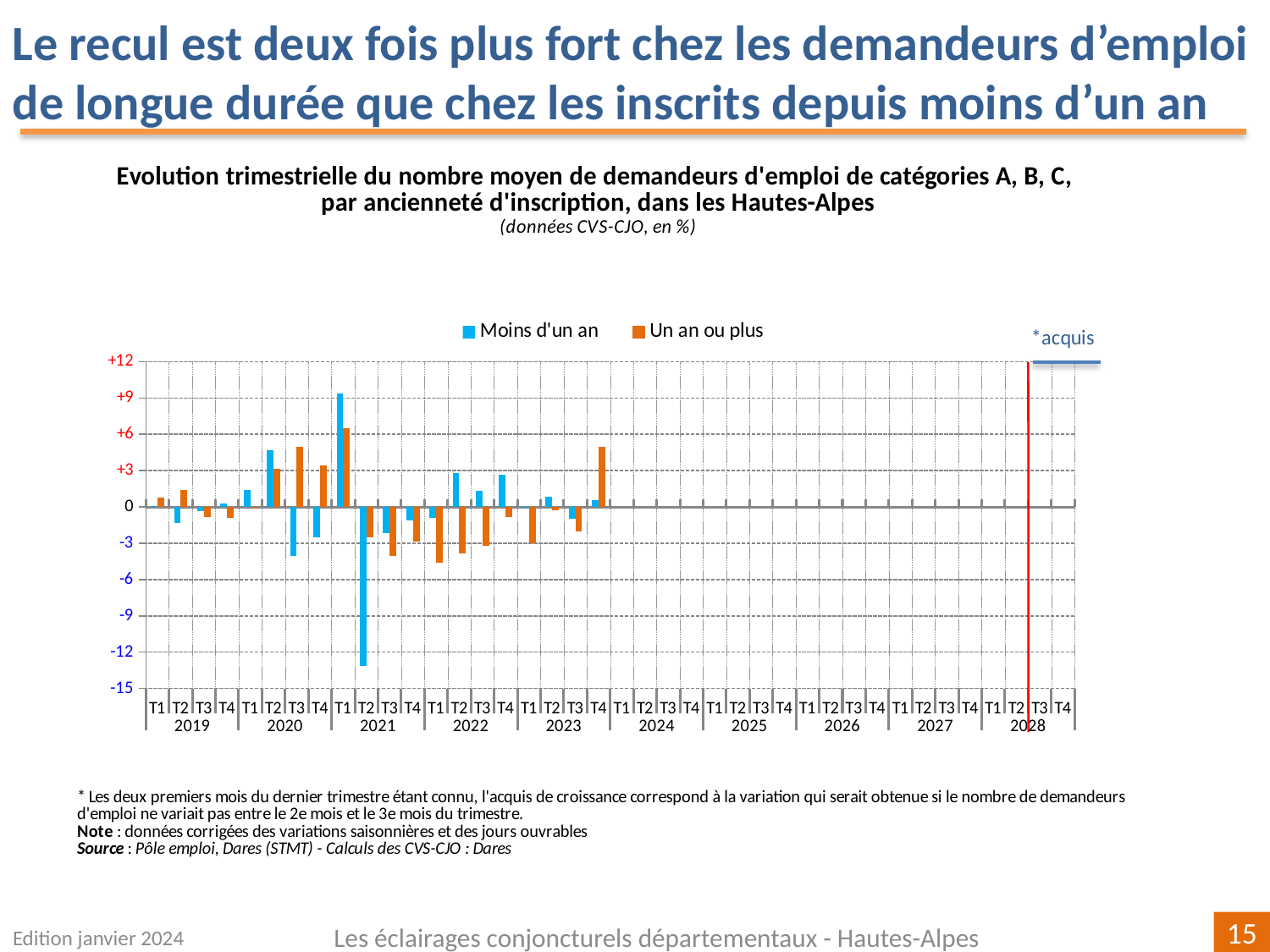
In which quarter does the 'Moins d'un an' series reach its highest value? T1 2021 In which quarter does the 'Moins d'un an' series reach its lowest value? T2 2021 In T2 2021, which series has the larger value, 'Moins d'un an' or 'Un an ou plus'? Un an ou plus In T1 2021, which series has the larger value, 'Moins d'un an' or 'Un an ou plus'? Moins d'un an In which quarter does the 'Un an ou plus' series reach its highest value? T1 2021 What are the two series named in the legend? Moins d'un an; Un an ou plus Is the value for 'Un an ou plus' in T1 2021 greater or less than +6? greater Is the value for 'Un an ou plus' in T4 2023 greater or less than +3? greater How many series does the legend list? 2 What kind of chart is shown on the slide? bar chart Is the value for 'Moins d'un an' in T2 2021 greater or less than -12? less